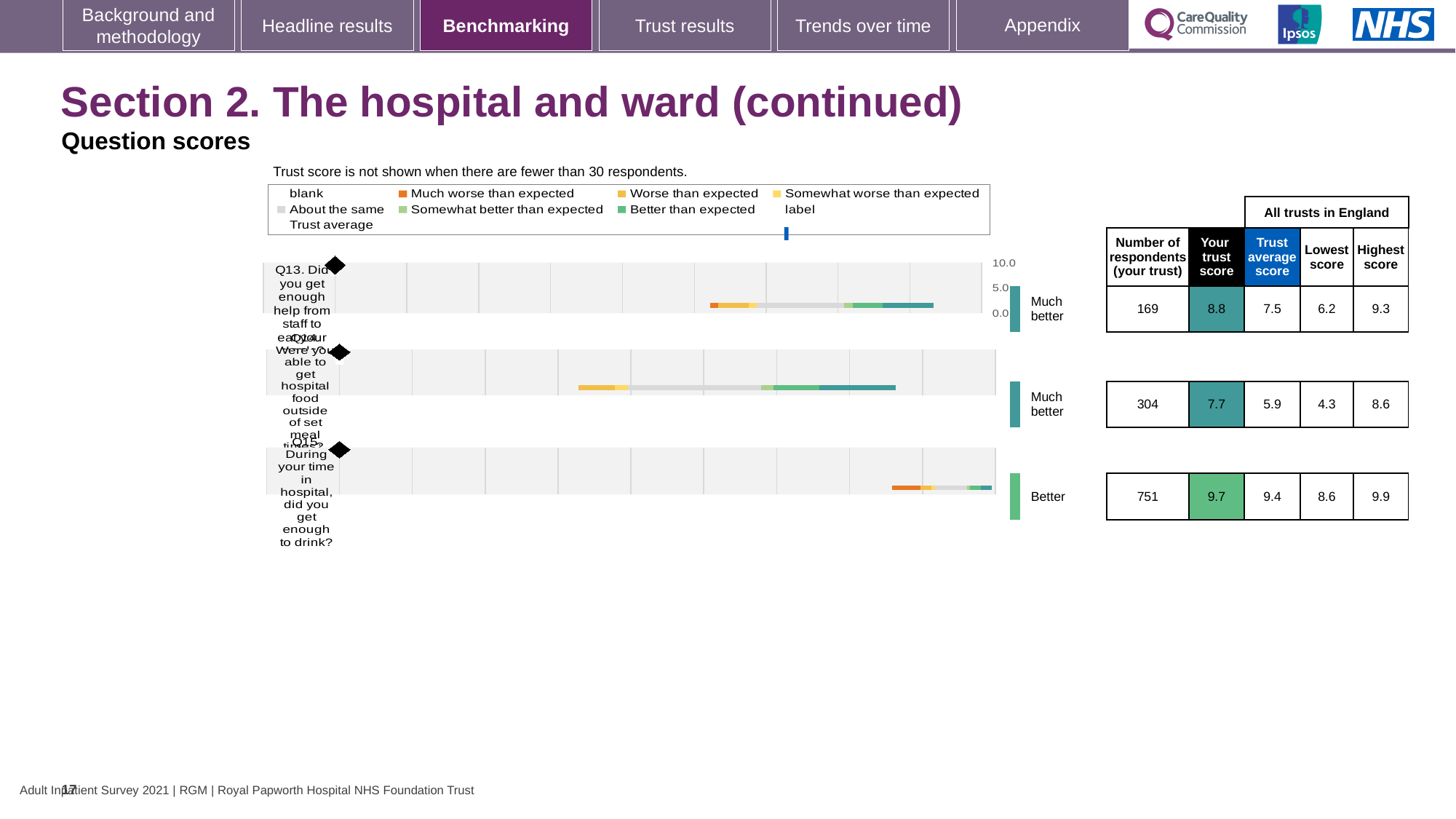
For Q14, which is larger: the trust score or the trust average score? trust score What is the trust score for Q13 (Did you get enough help from staff to eat your meals?)? 8.8 Which question has the lowest trust average score on this slide? Q14 How many respondents from the trust answered Q14? 304 What is the difference between the trust score and the trust average score for Q13? 1.3 What kind of chart is used to show the question scores on this slide? bar chart What is the difference between the highest and lowest scores for Q15? 1.3 What is the highest score across all trusts in England for Q15 (did you get enough to drink?)? 9.9 Which question has the highest trust score on this slide? Q15 How many questions (categories) are plotted in the benchmarking charts on this slide? 3 What is the trust average score for Q14 (Were you able to get hospital food outside of set meal times?)? 5.9 What benchmark category label is shown next to the Q15 chart? Better